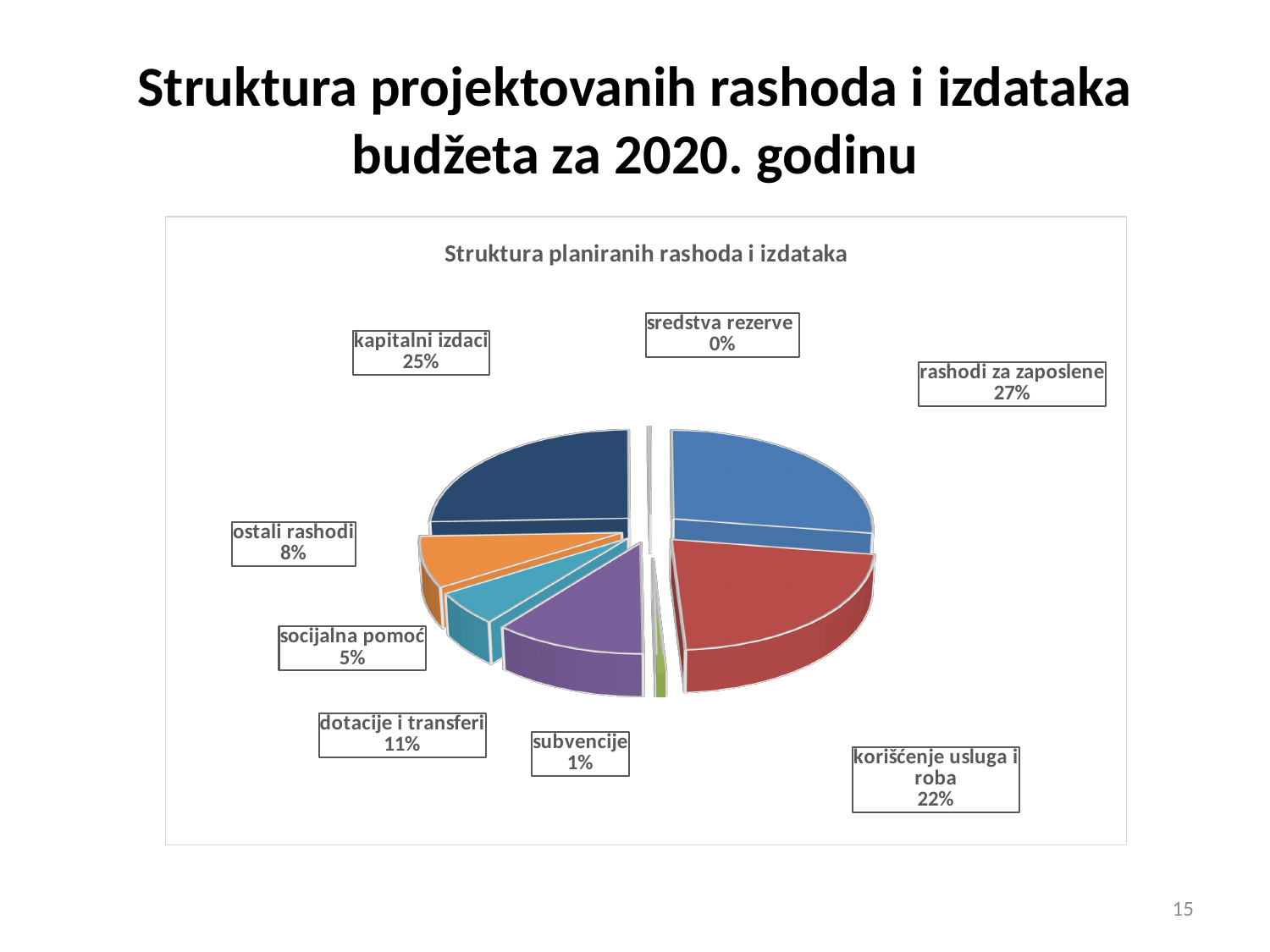
What is the title of the chart? Struktura planiranih rashoda i izdataka How many categories are shown in the pie chart? 8 Which category has the smallest share of the pie? sredstva rezerve What share of the pie does 'kapitalni izdaci' represent? 25% What share of the pie does 'rashodi za zaposlene' represent? 27% What is the difference in percentage points between 'rashodi za zaposlene' and 'korišćenje usluga i roba'? 5 Which category has the largest share of the pie? rashodi za zaposlene What is the value shown for 'korišćenje usluga i roba'? 22% Which is larger, 'ostali rashodi' or 'dotacije i transferi'? dotacije i transferi What is the value shown for 'dotacije i transferi'? 11% What is the value shown for 'socijalna pomoć'? 5% What kind of chart is shown on the slide? pie chart